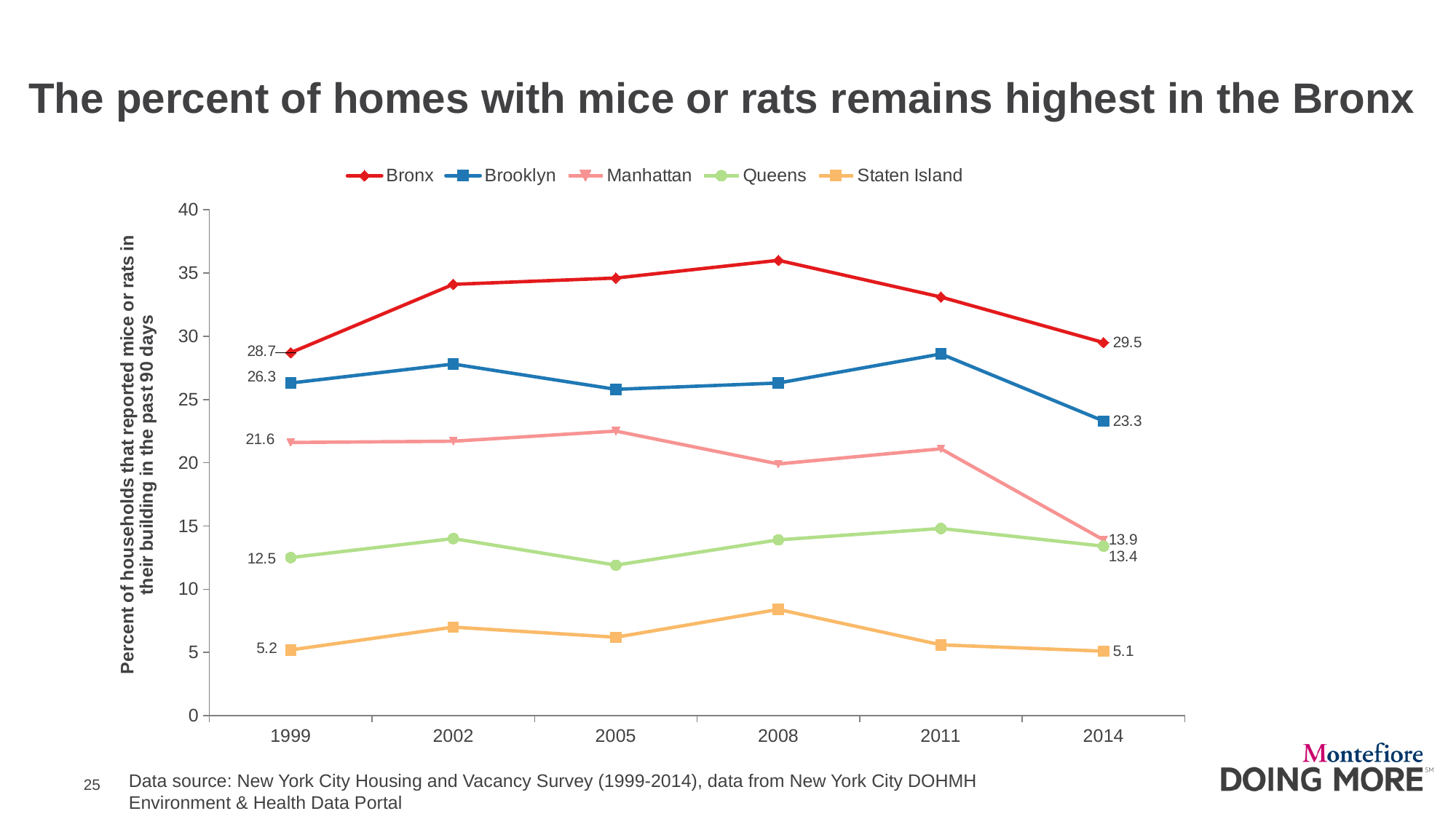
What was the value for Staten Island in 2014? 5.1 How many years are plotted along the x axis? 6 Which borough had the lowest percent of households reporting mice or rats in 1999? Staten Island What was the value for Manhattan in 1999? 21.6 What kind of chart is shown on the slide? line chart Is the value for the Bronx in 2008 greater or less than 30? greater By how much did the Manhattan value fall from 1999 to 2014? 7.7 Which borough had the highest percent of households reporting mice or rats in 2014? Bronx Which was larger in 2014, the value for Manhattan or the value for Queens? Manhattan What was the value for Brooklyn in 2014? 23.3 How many series does the legend list? 5 What was the percent of households reporting mice or rats in the Bronx in 1999? 28.7